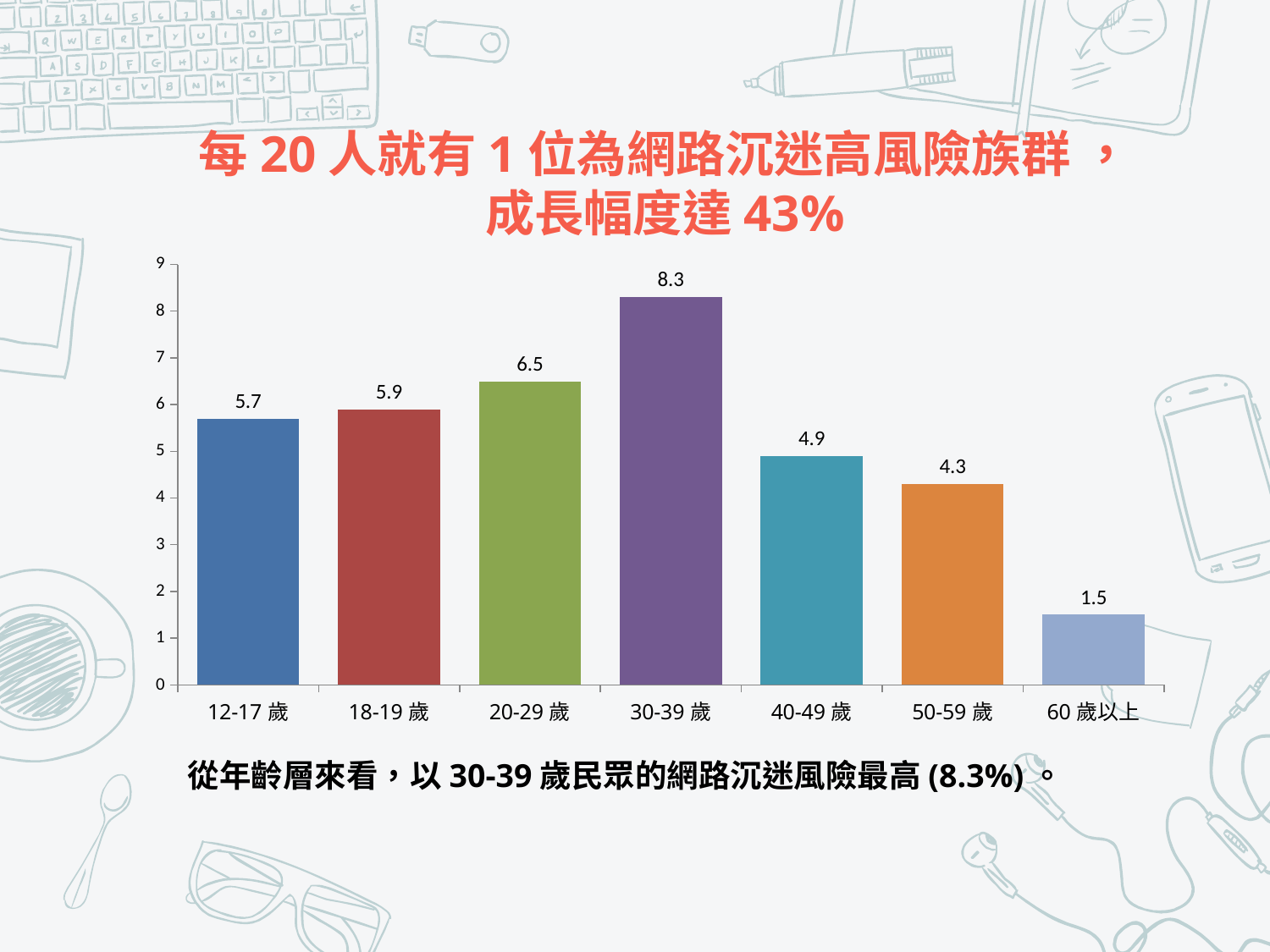
What is the difference between the values for 20-29 歲 and 60 歲以上? 5 Which age group has the lowest value? 60 歲以上 Which age group has the highest value? 30-39 歲 What is the value for the 30-39 歲 age group? 8.3 What is the value for the 12-17 歲 age group? 5.7 What is the difference between the values for 30-39 歲 and 40-49 歲? 3.4 What is the value for the 60 歲以上 age group? 1.5 What is the maximum value shown on the vertical axis? 9 Is the value for 40-49 歲 greater or less than 5? less What kind of chart is shown on the slide? bar chart Which is larger, the value for 18-19 歲 or the value for 50-59 歲? 18-19 歲 How many age groups are shown on the chart? 7